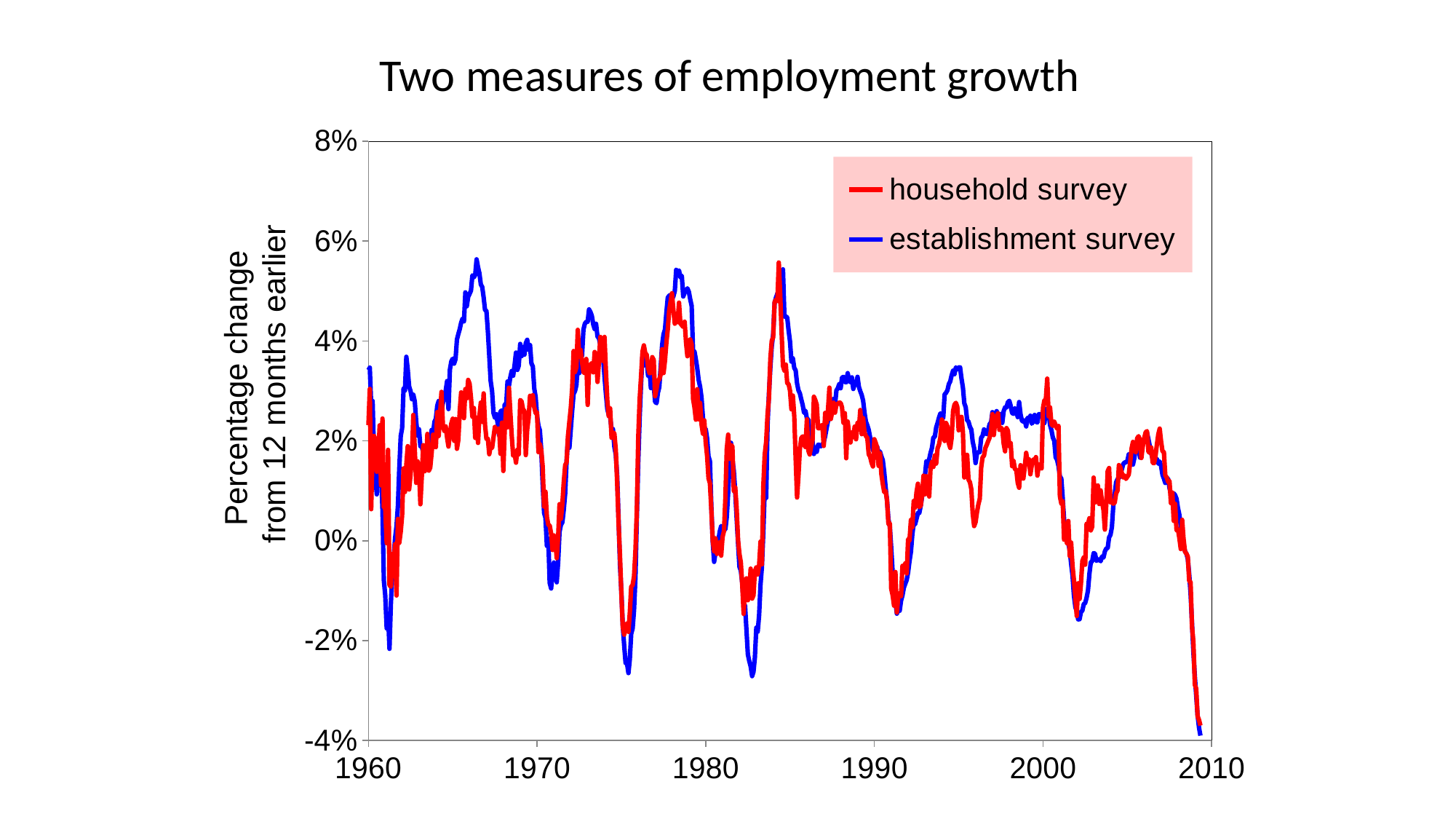
What is the lowest value shown on the y axis? -4% Do the two series rise or fall between 2007 and 2009? fall What is the title of the chart? Two measures of employment growth Is the household survey value around 1975 greater or less than 0%? less Is the household survey value at the end of the series (around 2009) greater or less than -2%? less Which colour is used for the establishment survey line? blue What kind of chart is shown on the slide? line chart How many series does the legend list? 2 Is the establishment survey value around 1966 greater or less than 4%? greater Does the establishment survey rise or fall between 1991 and 1994? rise Around 1966, which series is higher, the household survey or the establishment survey? establishment survey